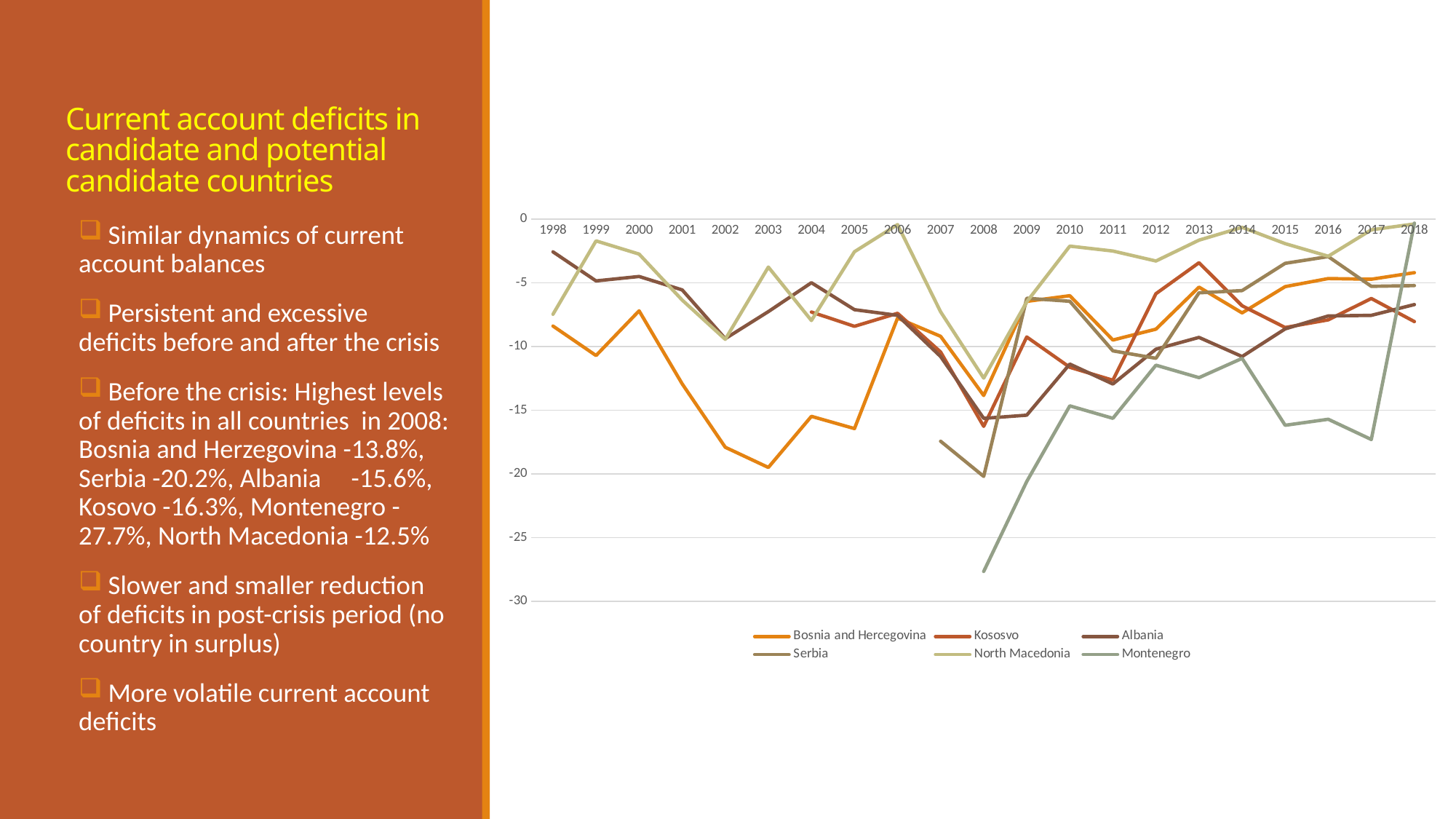
What kind of chart is shown on the slide? line chart Which is larger in 2002, the value for Bosnia and Hercegovina or the value for Albania? Albania Which series in the legend is drawn in the lightest (pale yellow-green) colour? North Macedonia How many years are shown on the x axis of the chart? 21 Is the value for Bosnia and Hercegovina in 2003 greater or less than -15? less Which country has the lowest value in 2008? Montenegro Is the value for North Macedonia in 2006 greater or less than -5? greater Is the value for Montenegro in 2008 greater or less than -25? less Which is larger in 2017, the value for Montenegro or the value for Serbia? Serbia How many series does the chart legend list? 6 Does the Montenegro line rise or fall from 2008 to 2010? rise